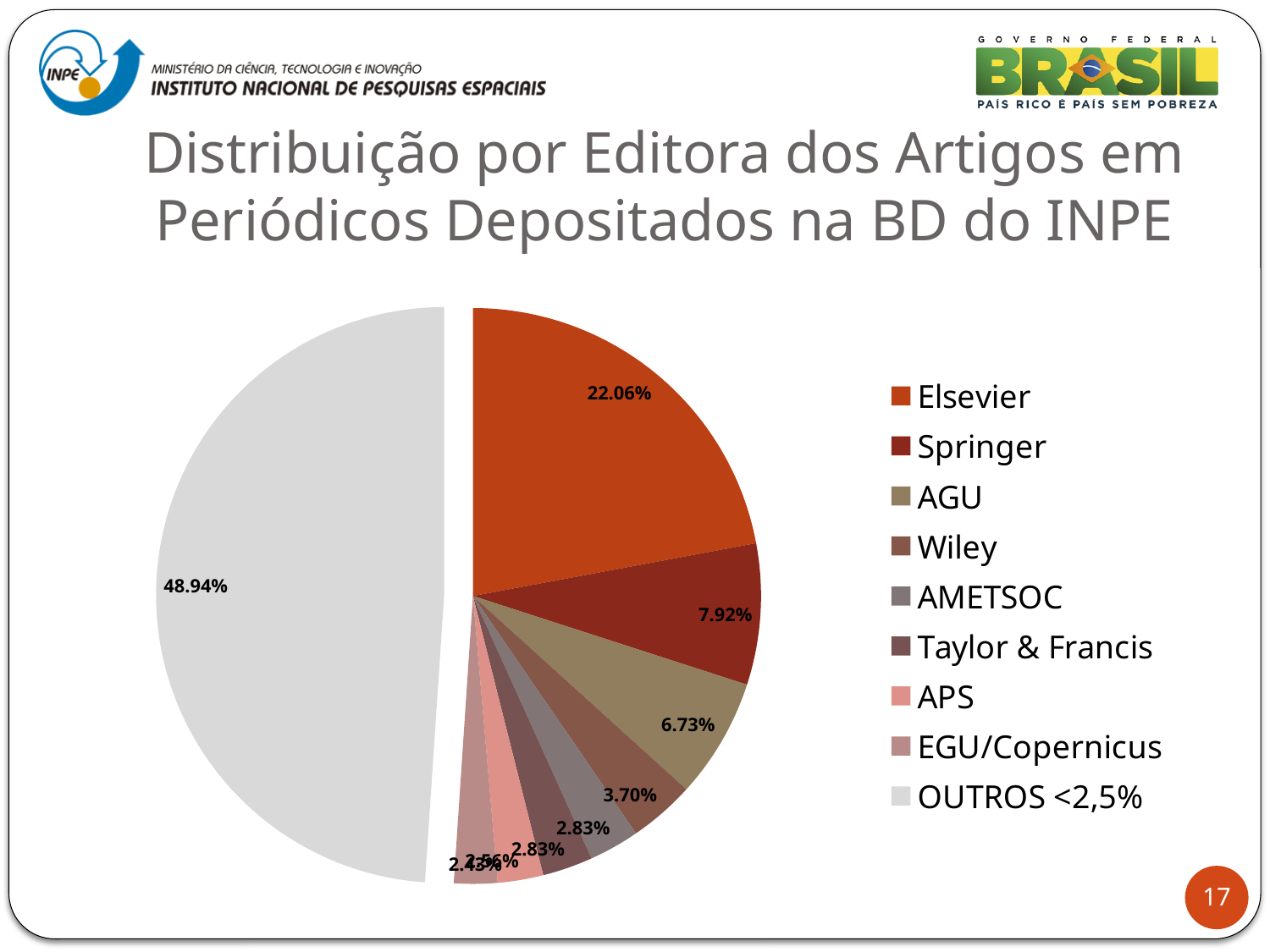
Which category has the largest slice of the pie? OUTROS <2,5% Which named publisher (excluding OUTROS) has the largest share? Elsevier Which is larger, the share for Springer or the share for AGU? Springer Which is larger, the share for Wiley or the share for AMETSOC? Wiley What is the value for AGU? 6.73% What type of chart is shown on the slide? Pie chart What is the difference between the Elsevier and Springer shares? 14.14% How many categories does the legend list? 9 What share of the pie does Elsevier hold? 22.06% What percentage is shown for Springer? 7.92% What share of the pie is labelled OUTROS <2,5%? 48.94% What percentage is shown for Wiley? 3.70%